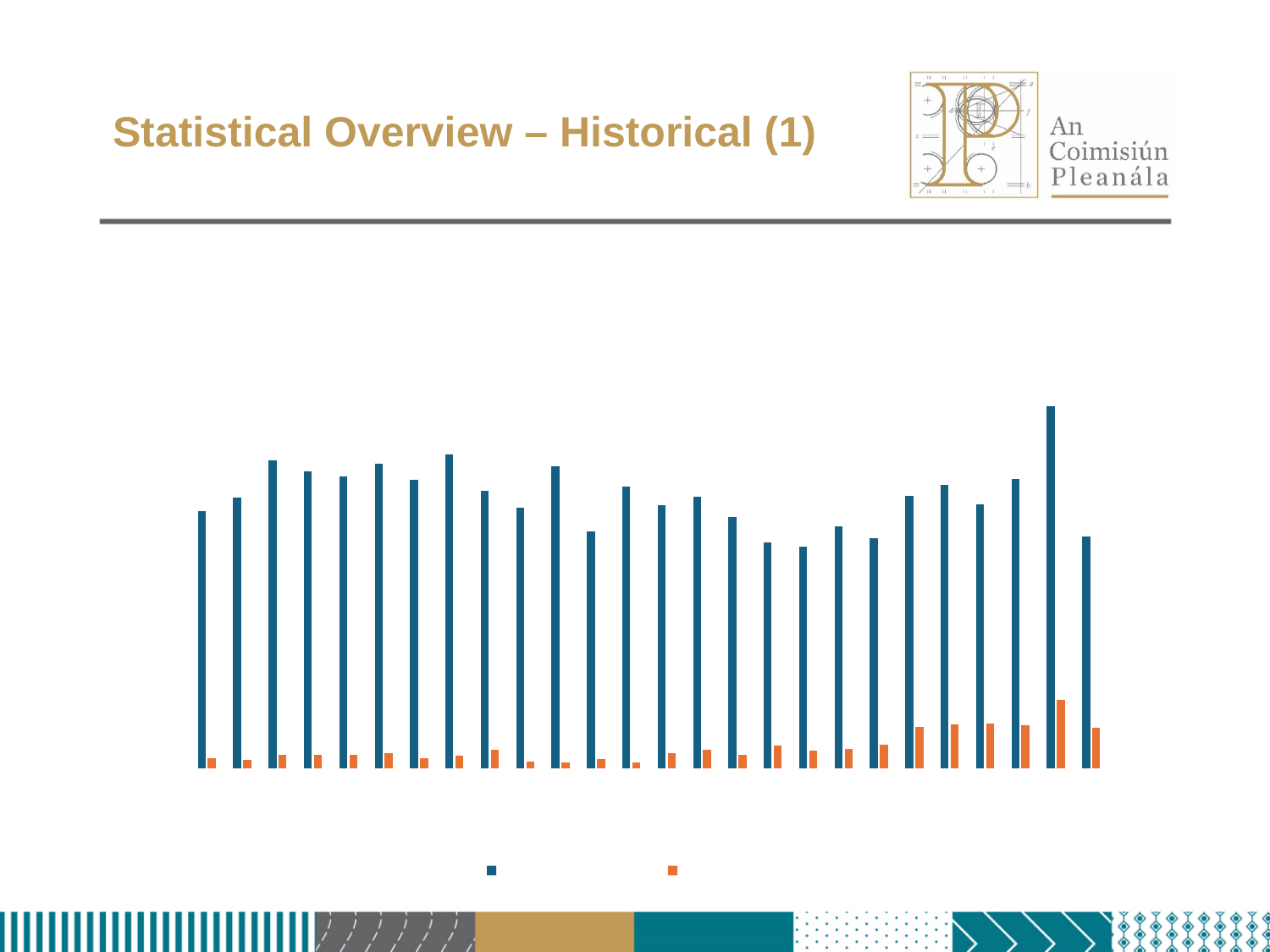
Where is the tallest blue bar located: near the left end or near the right end of the chart? near the right end Do the orange bars generally rise or fall moving from left to right along the x axis? rise How many categories (groups of bars) are plotted in the chart? 26 Which series has the taller bars overall, the blue series or the orange series? blue What kind of chart is shown on the slide? bar chart Is the tallest bar in the chart blue or orange? blue How many series does the legend list? 2 Is the tallest orange bar located near the left end or near the right end of the chart? near the right end What colours are used for the two series in the chart? blue and orange